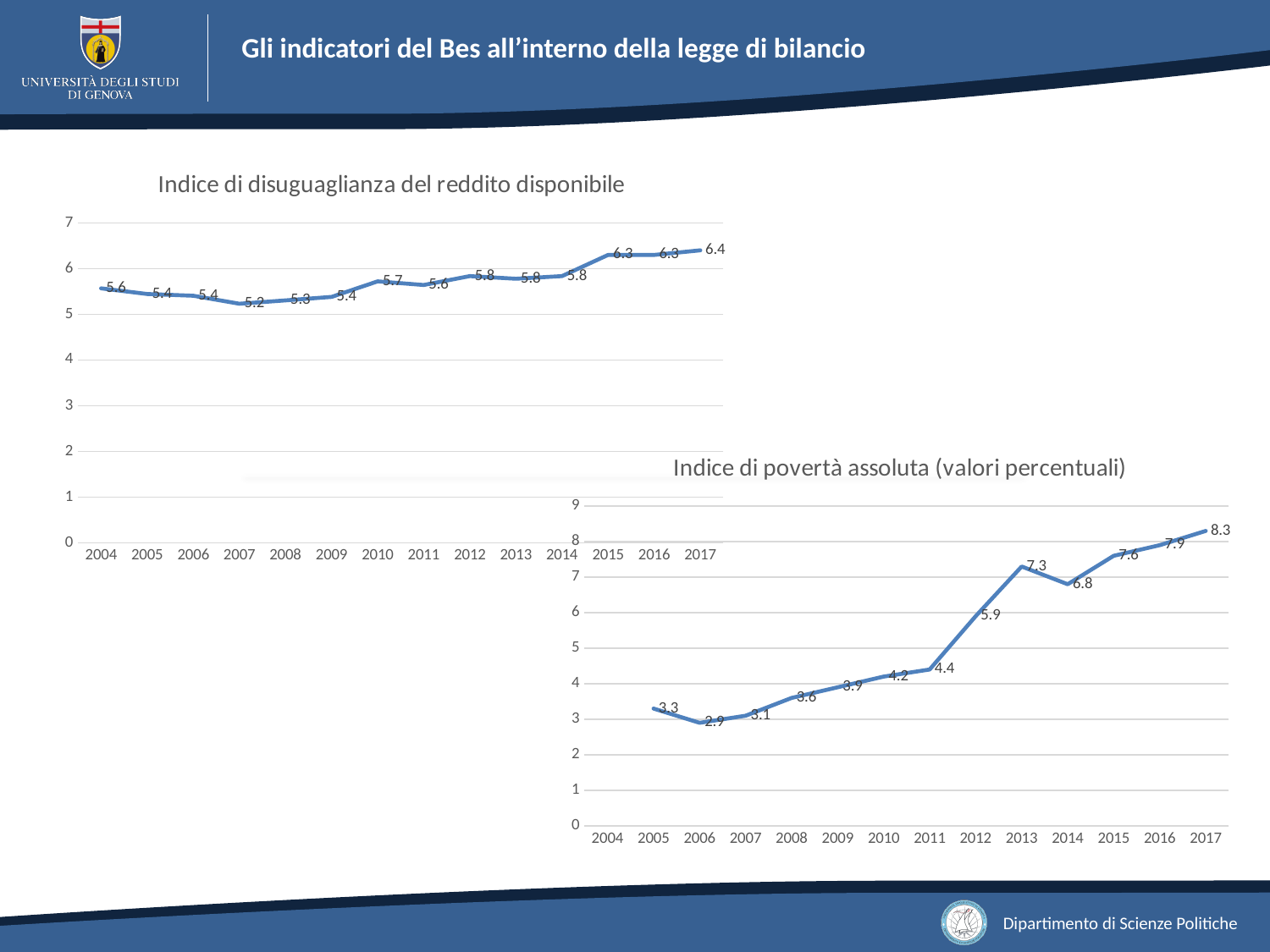
In the chart 'Indice di disuguaglianza del reddito disponibile', what is the difference between the 2017 value and the 2004 value? 0.8 In the chart 'Indice di disuguaglianza del reddito disponibile', what kind of chart is shown? Line chart In the chart 'Indice di povertà assoluta (valori percentuali)', is the value for 2014 larger or smaller than the value for 2013? Smaller In the chart 'Indice di povertà assoluta (valori percentuali)', what is the value for 2013? 7.3 In the chart 'Indice di disuguaglianza del reddito disponibile', what is the value for 2007? 5.2 In the chart 'Indice di povertà assoluta (valori percentuali)', which year has the lowest value? 2006 In the chart 'Indice di povertà assoluta (valori percentuali)', what is the difference between the 2017 value and the 2005 value? 5 In the chart 'Indice di povertà assoluta (valori percentuali)', which year has the highest value? 2017 In the chart 'Indice di disuguaglianza del reddito disponibile', what is the value for 2017? 6.4 In the chart 'Indice di disuguaglianza del reddito disponibile', which year has the lowest value? 2007 In the chart 'Indice di povertà assoluta (valori percentuali)', what is the value for 2006? 2.9 In the chart 'Indice di povertà assoluta (valori percentuali)', do the values generally rise or fall from 2006 to 2017? Rise